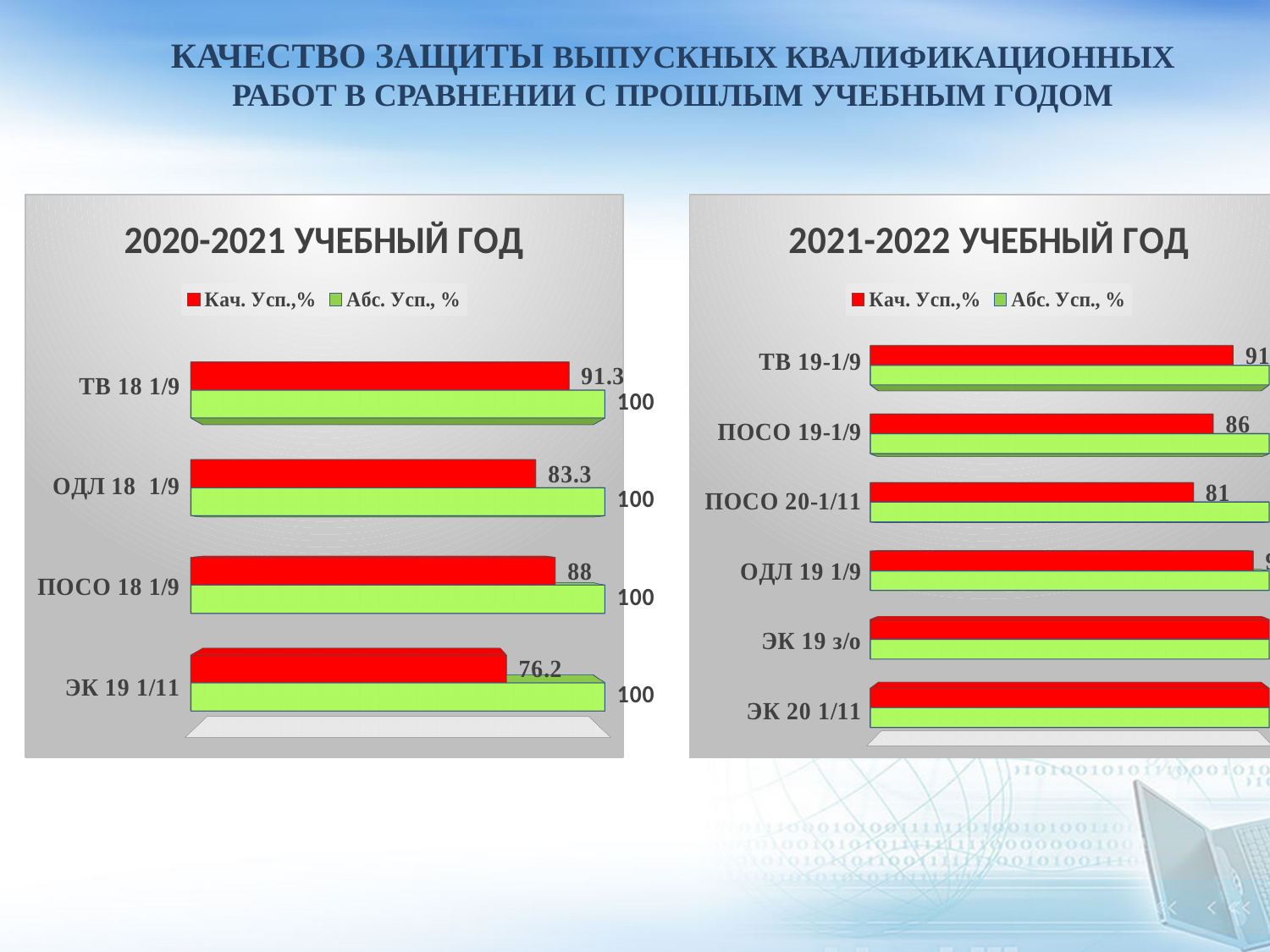
In the 2020-2021 УЧЕБНЫЙ ГОД chart, what is the Кач. Усп.,% value for ТВ 18 1/9? 91.3 In the 2021-2022 УЧЕБНЫЙ ГОД chart, which has the larger Кач. Усп.,% value: ТВ 19-1/9 or ПОСО 20-1/11? ТВ 19-1/9 In the 2020-2021 УЧЕБНЫЙ ГОД chart, how many categories are shown? 4 In the 2020-2021 УЧЕБНЫЙ ГОД chart, what is the Кач. Усп.,% value for ЭК 19 1/11? 76.2 In the 2020-2021 УЧЕБНЫЙ ГОД chart, what is the Абс. Усп., % value for ОДЛ 18 1/9? 100 How many series does the legend of the 2021-2022 УЧЕБНЫЙ ГОД chart list? 2 In the 2020-2021 УЧЕБНЫЙ ГОД chart, what is the difference between the Кач. Усп.,% values for ПОСО 18 1/9 and ОДЛ 18 1/9? 4.7 In the 2020-2021 УЧЕБНЫЙ ГОД chart, which category has the highest Кач. Усп.,% value? ТВ 18 1/9 In the 2021-2022 УЧЕБНЫЙ ГОД chart, what is the Кач. Усп.,% value for ПОСО 19-1/9? 86 In the 2021-2022 УЧЕБНЫЙ ГОД chart, how many categories are shown? 6 In the 2021-2022 УЧЕБНЫЙ ГОД chart, what is the Кач. Усп.,% value for ПОСО 20-1/11? 81 In the 2020-2021 УЧЕБНЫЙ ГОД chart, which category has the lowest Кач. Усп.,% value? ЭК 19 1/11